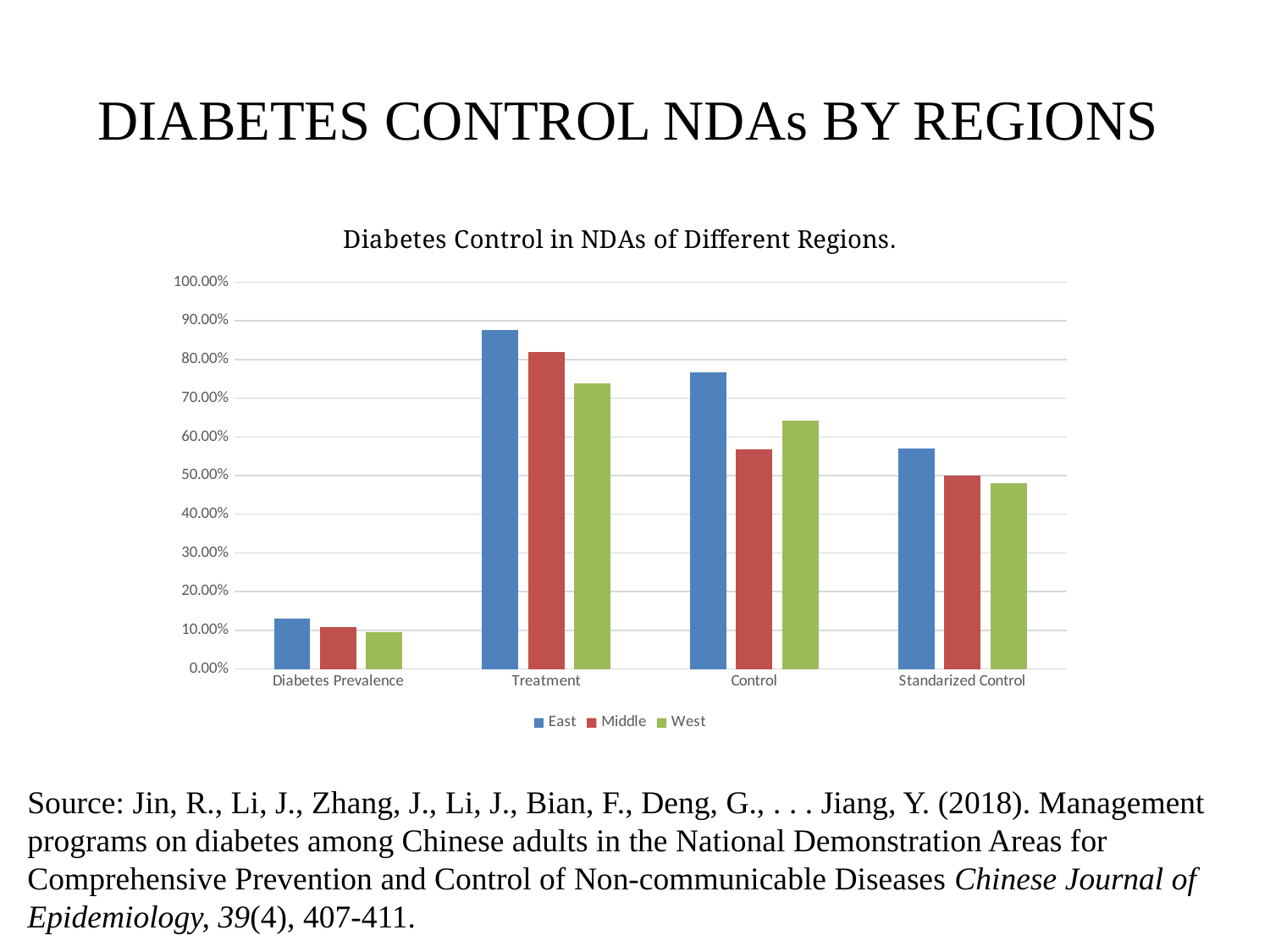
Is the West value for Treatment greater or less than 80.00%? less What kind of chart is shown on the slide? bar chart For which category is the East bar the highest? Treatment For Control, which is larger: the Middle value or the West value? West How many categories are shown on the x axis? 4 Which category has the lowest values for all three regions? Diabetes Prevalence Is the Middle value for Control greater or less than 60.00%? less Is the East value for Treatment greater or less than 80.00%? greater Which region is represented by the green bars? West How many series does the legend list? 3 What is the title of the chart? Diabetes Control in NDAs of Different Regions.